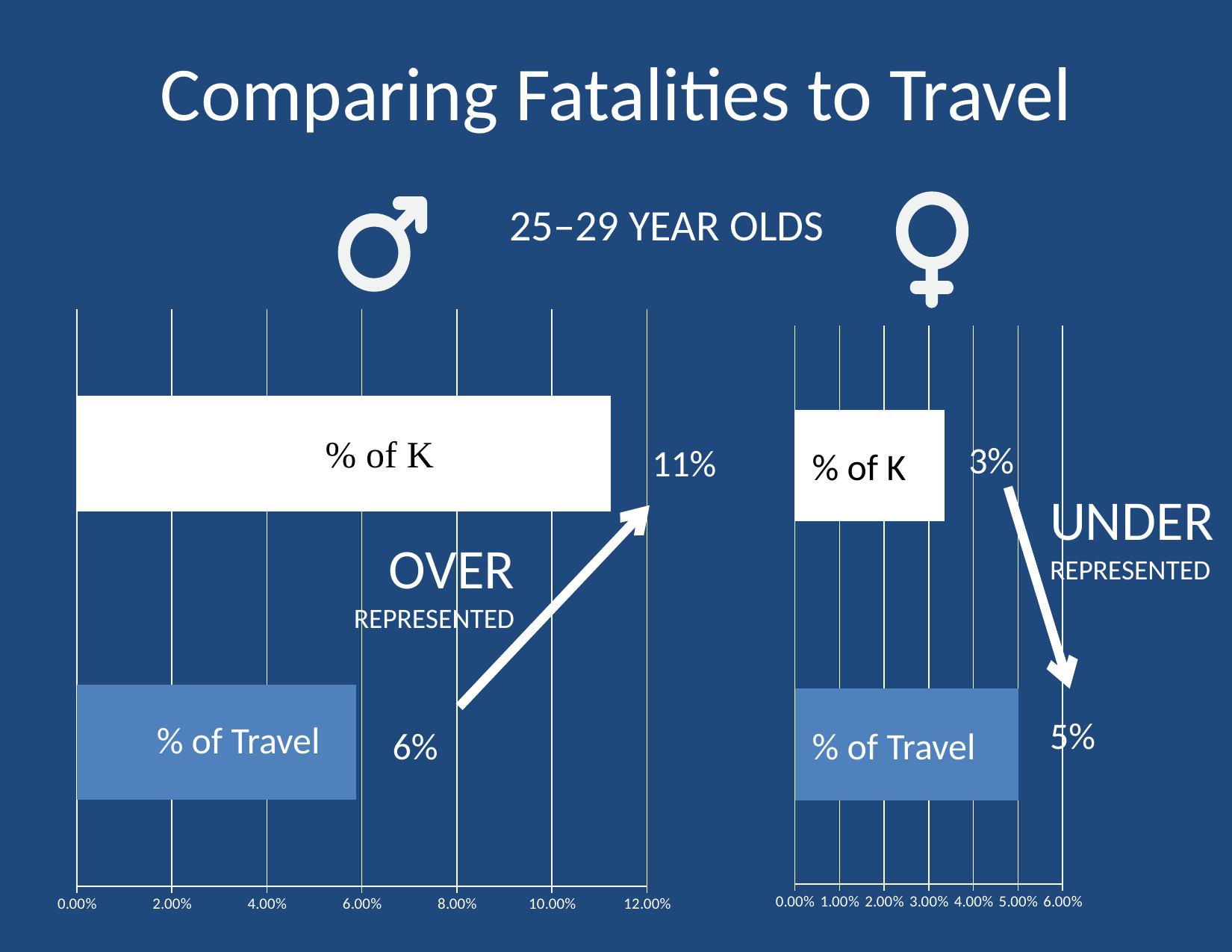
On the right chart (female), which bar is longer, % of K or % of Travel? % of Travel On the right chart (female), what is the value for % of K? 3% On the left chart (male), what is the value for % of K? 11% On the left chart (male), which bar is longer, % of K or % of Travel? % of K What kind of chart is shown on the left side of the slide? Bar chart What is the title of the slide? Comparing Fatalities to Travel On the left chart (male), what is the value for % of Travel? 6% How many bars are plotted on the right chart (female)? 2 On the right chart (female), what is the value for % of Travel? 5% On the right chart (female), what is the difference between % of Travel and % of K? 2% On the left chart (male), what is the difference between % of K and % of Travel? 5% On the left chart (male), is the value for % of K greater or less than 10.00%? greater